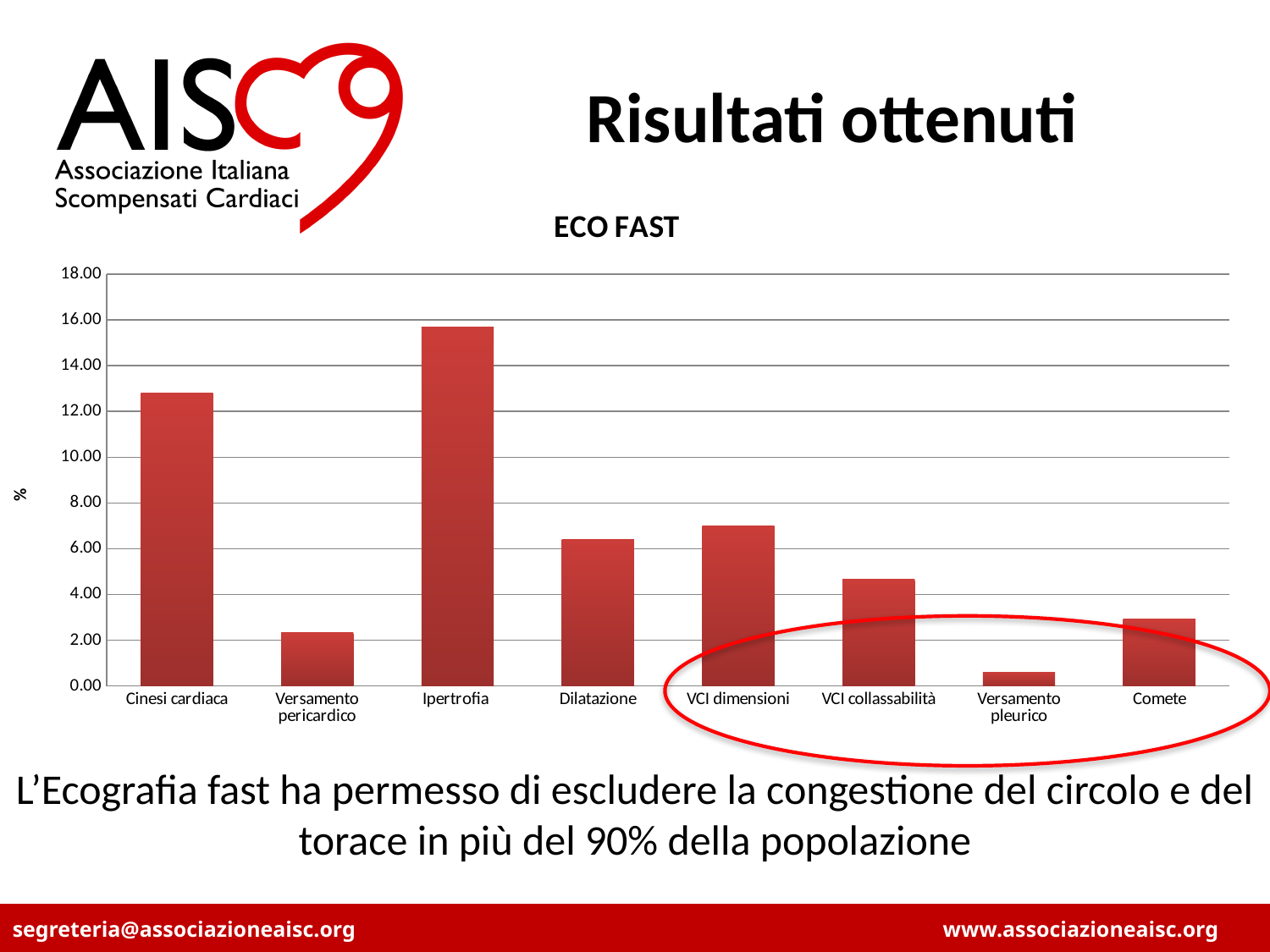
Which is larger, the value for Comete or the value for Versamento pleurico? Comete What label is shown on the vertical axis of the chart? % Is the value for Versamento pericardico greater or less than 4.00? less Which is larger, the value for Dilatazione or the value for VCI collassabilità? Dilatazione Is the value for Cinesi cardiaca greater or less than 12.00? greater Which category has the lowest value in the chart? Versamento pleurico Is the value for VCI dimensioni greater or less than 6.00? greater What kind of chart is shown on the slide? bar chart What is the title of the chart? ECO FAST How many categories are plotted on the x axis of the chart? 8 Which category has the highest value in the chart? Ipertrofia